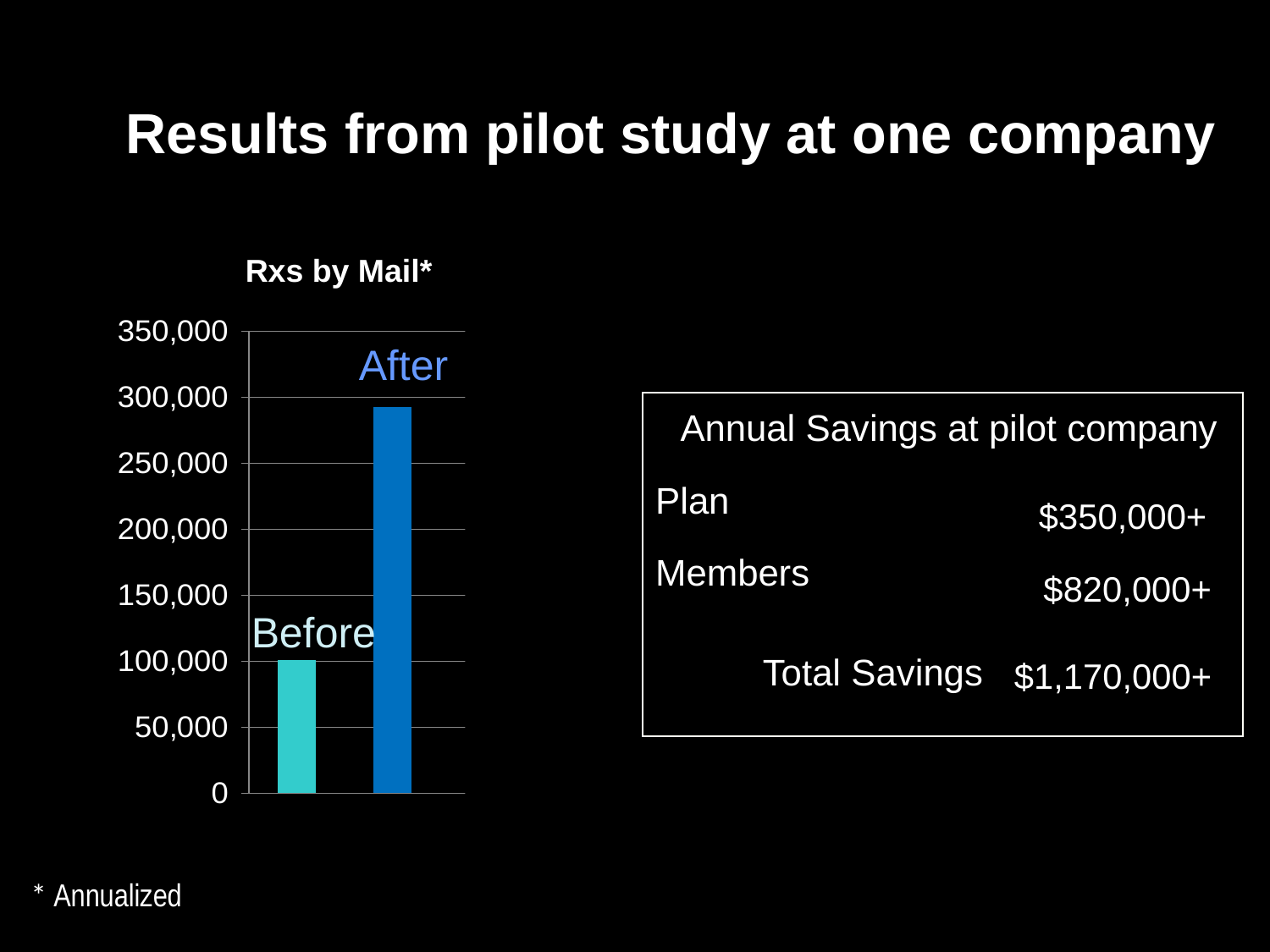
Do the values rise or fall from Before to After? rise Is the value for Before greater or less than 150,000? less Is the value for After greater or less than 300,000? less How many bars are plotted in the chart? 2 Is the value for Before greater or less than 50,000? greater Which category has the lowest value in the chart? Before What is the maximum value shown on the vertical axis of the chart? 350,000 Which is larger, the value for Before or the value for After? After What kind of chart is shown on the slide? bar chart What is the title of the chart? Rxs by Mail* Which category has the highest value in the chart? After